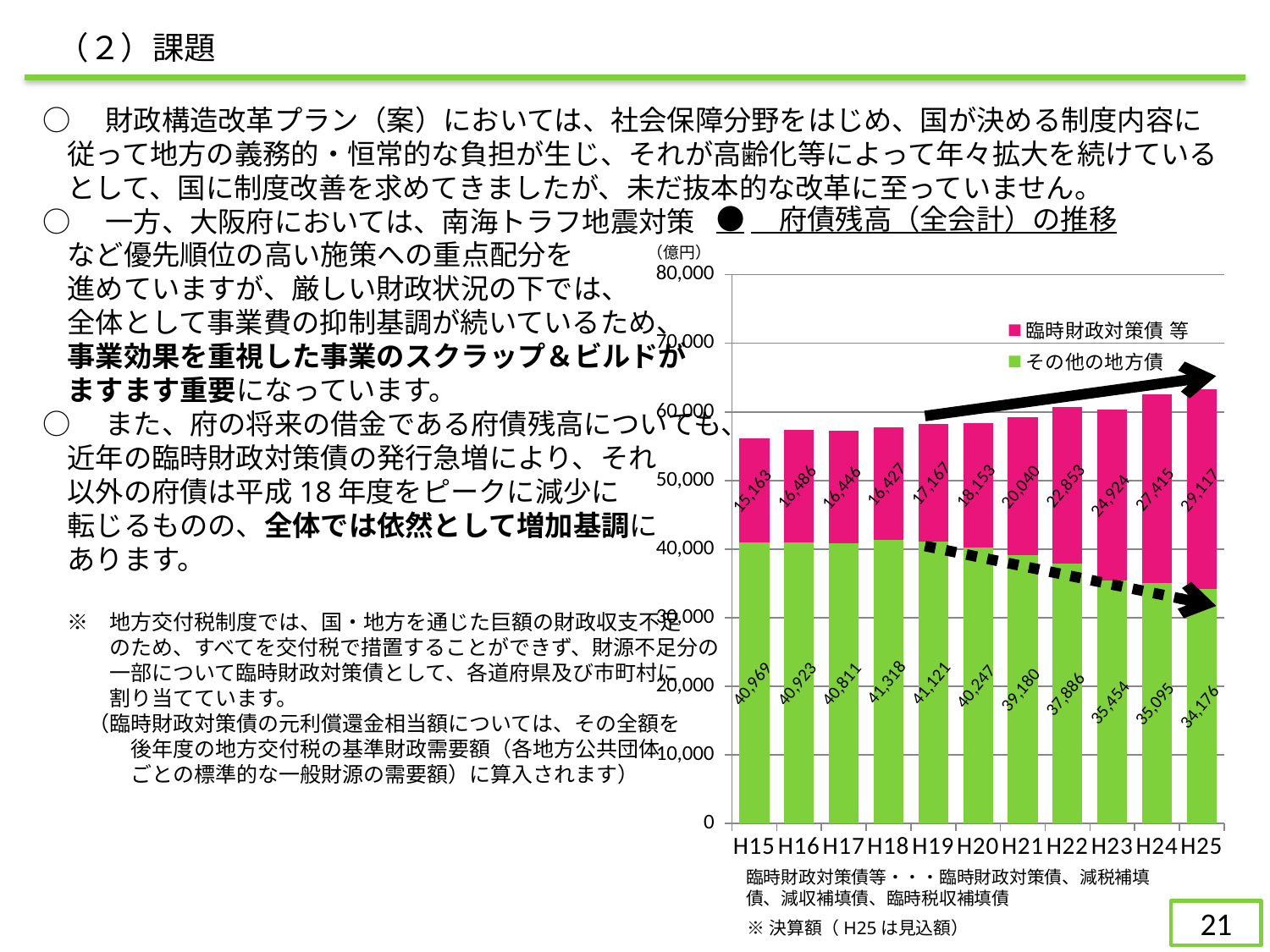
In which year is その他の地方債 highest? H18 What kind of chart is shown on the slide? Stacked bar chart What is the value of その他の地方債 for H18? 41,318 How many fiscal years are plotted on the x axis of the chart? 11 How many series does the legend of the 府債残高（全会計）の推移 chart list? 2 Does 臨時財政対策債 等 rise or fall from H19 to H25? Rise Which is larger, その他の地方債 in H19 or in H25? H19 In which year is 臨時財政対策債 等 lowest? H15 What is the value of 臨時財政対策債 等 for H15? 15,163 What is the total of the stacked bar for H25? 63,293 What is the value of 臨時財政対策債 等 for H25? 29,117 By how much did 臨時財政対策債 等 increase from H15 to H25? 13,954